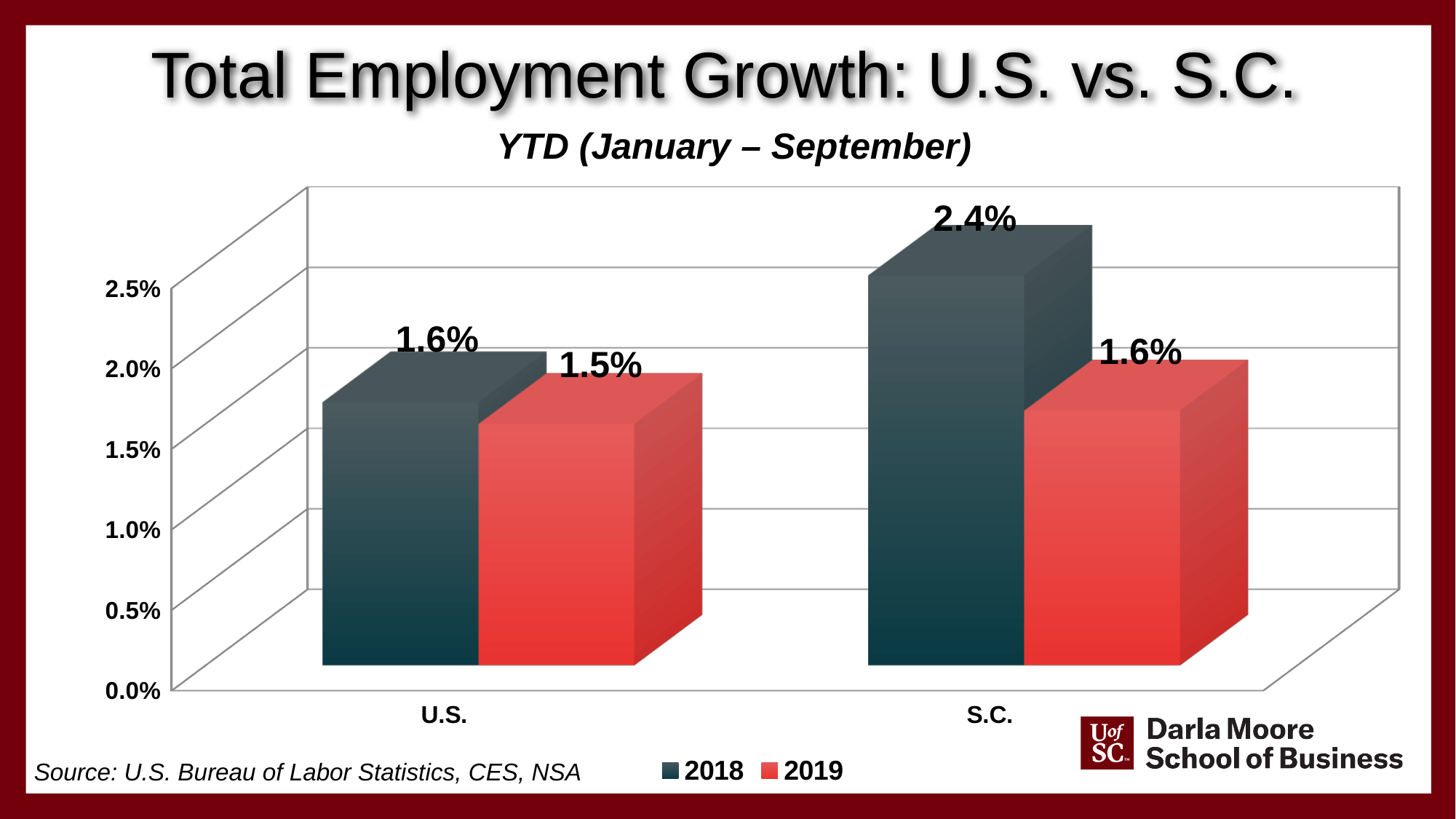
Which is larger: the 2018 value for S.C. or the 2018 value for the U.S.? S.C. What is the 2018 employment growth value for the U.S.? 1.6% What is the 2018 employment growth value for S.C.? 2.4% What is the 2019 employment growth value for S.C.? 1.6% What is the 2019 employment growth value for the U.S.? 1.5% Which category has the highest 2018 value? S.C. Which category has the lowest 2019 value? U.S. How many series does the legend list? 2 What is the difference between the S.C. and U.S. values for 2018? 0.8% What kind of chart is shown on the slide? Bar chart What is the difference between the 2018 and 2019 values for S.C.? 0.8% How many categories are shown on the x axis? 2